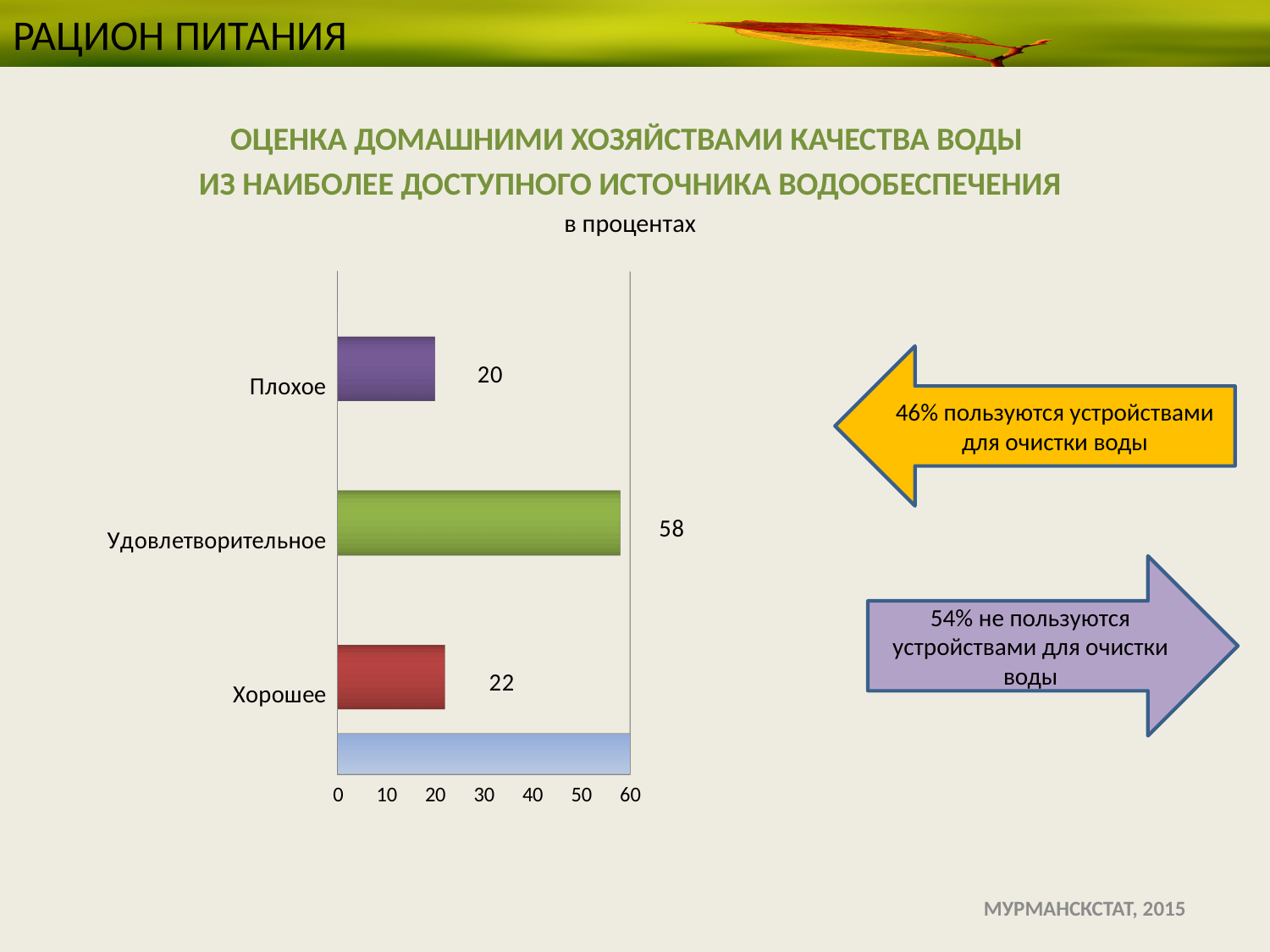
What is the value for Удовлетворительное? 58 Is the value for Удовлетворительное greater or less than 50? greater What is the value for Хорошее? 22 How many categories are shown in the chart? 3 What is the value for Плохое? 20 Which is larger, the value for Удовлетворительное or the value for Плохое? Удовлетворительное What is the maximum value shown on the horizontal axis of the chart? 60 What kind of chart is shown on the slide? bar chart Which category has the highest value? Удовлетворительное What is the difference between the values for Удовлетворительное and Хорошее? 36 Which category has the lowest value? Плохое What is the difference between the values for Хорошее and Плохое? 2